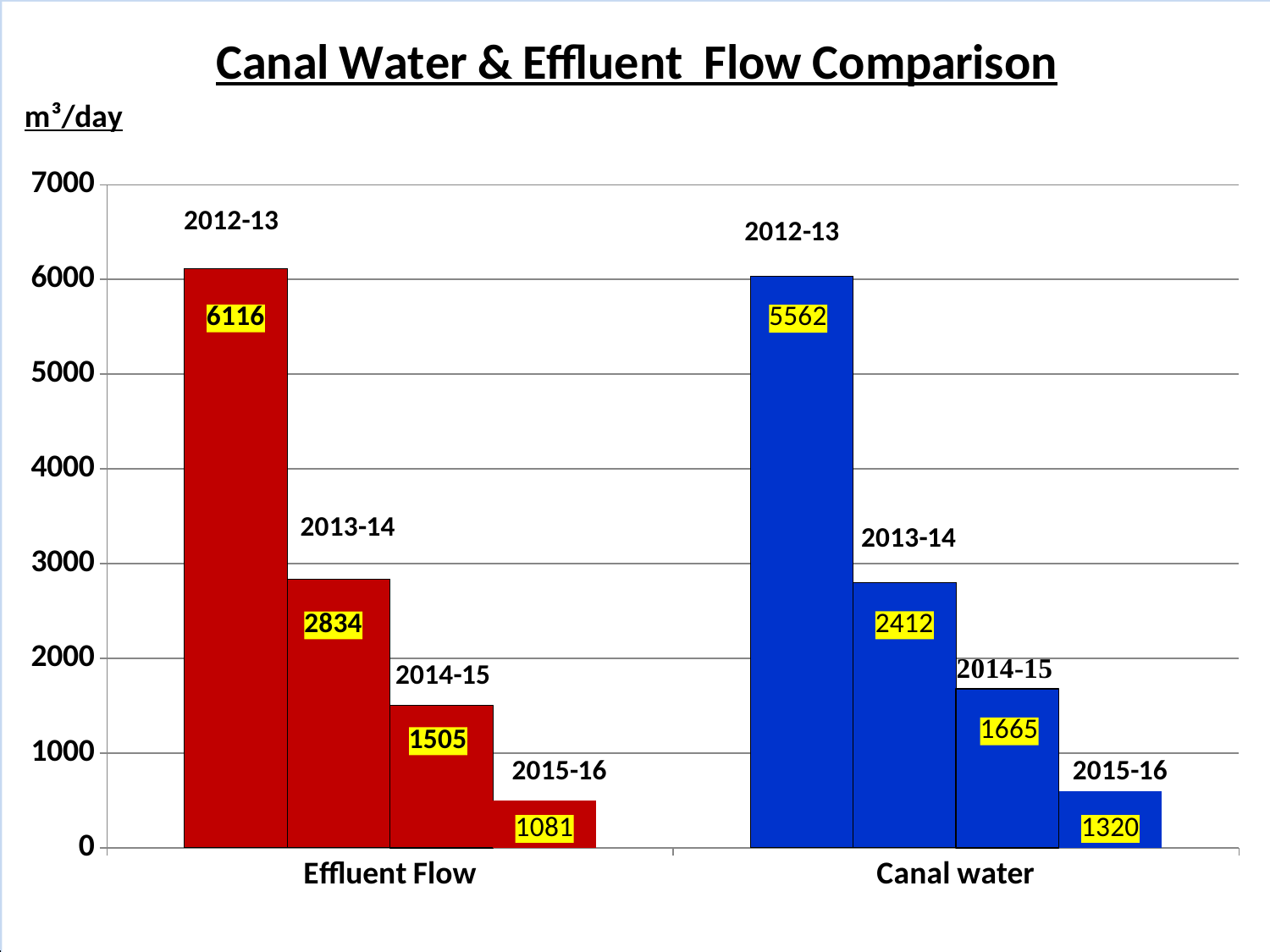
Which year has the lowest Canal water value? 2015-16 What is the difference between the Effluent Flow values for 2012-13 and 2013-14? 3282 What is the Canal water value for 2014-15? 1665 Do the Canal water values rise or fall from 2012-13 to 2015-16? fall What kind of chart is shown on the slide? bar chart What is the difference between the Effluent Flow and Canal water values for 2012-13? 554 Which is larger for 2013-14, Effluent Flow or Canal water? Effluent Flow What is the Effluent Flow value for 2012-13? 6116 Which year has the highest Effluent Flow? 2012-13 How many years are shown for Effluent Flow? 4 What is the Canal water value for 2015-16? 1320 Is the Canal water value for 2013-14 greater or less than 3000? less